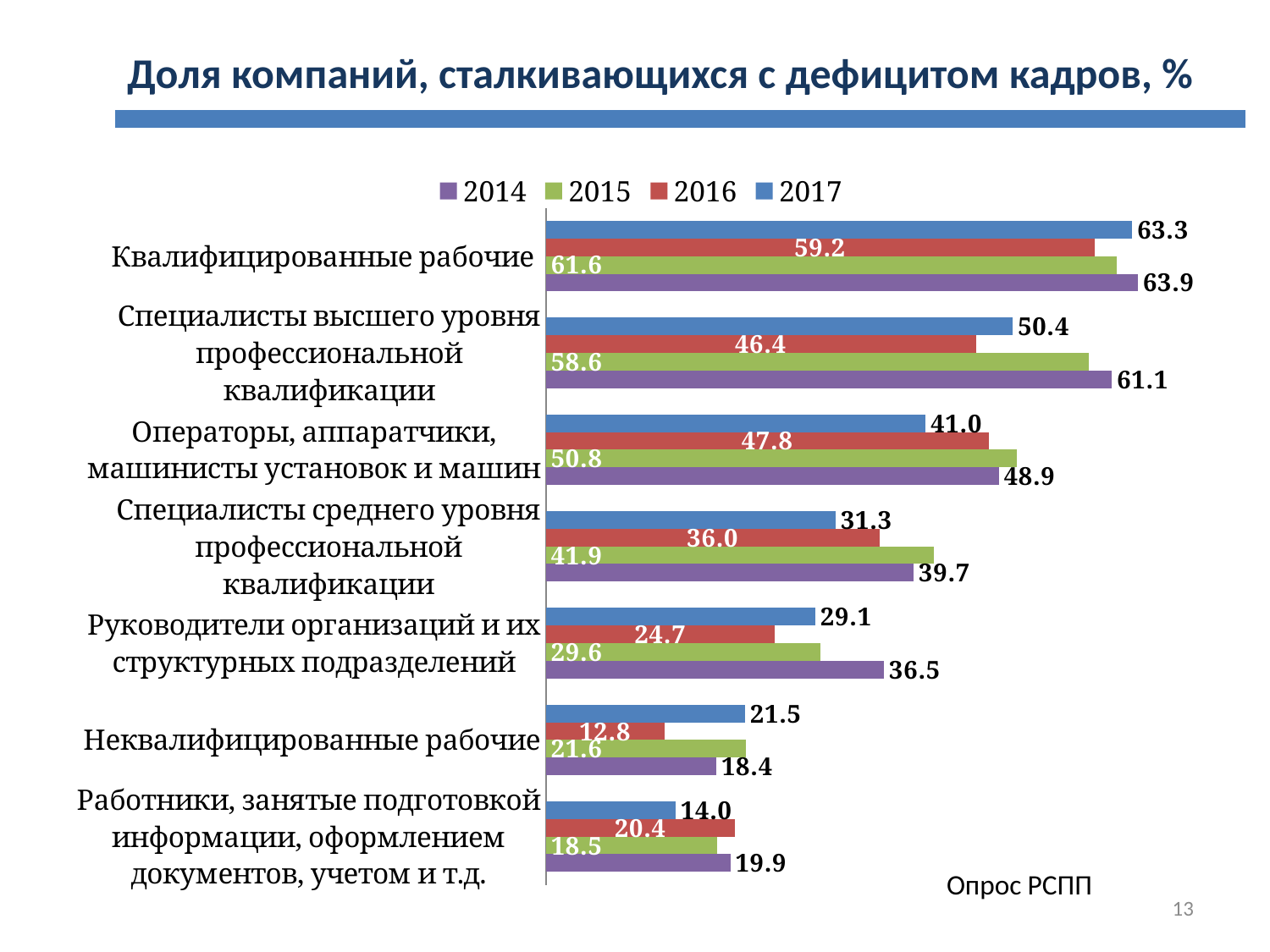
What type of chart is shown on the slide? bar chart Which category has the lowest 2017 value? Работники, занятые подготовкой информации, оформлением документов, учетом и т.д. How many series does the legend list? 4 What is the 2014 value for Специалисты высшего уровня профессиональной квалификации? 61.1 What is the 2015 value for Операторы, аппаратчики, машинисты установок и машин? 50.8 What is the difference between the 2014 and 2017 values for Специалисты высшего уровня профессиональной квалификации? 10.7 What is the title of the chart? Доля компаний, сталкивающихся с дефицитом кадров, % Which category has the highest 2017 value? Квалифицированные рабочие How many categories are shown on the chart? 7 For Руководители организаций и их структурных подразделений, which is larger: the 2014 value or the 2016 value? 2014 What is the 2017 value for Квалифицированные рабочие? 63.3 What is the 2016 value for Неквалифицированные рабочие? 12.8